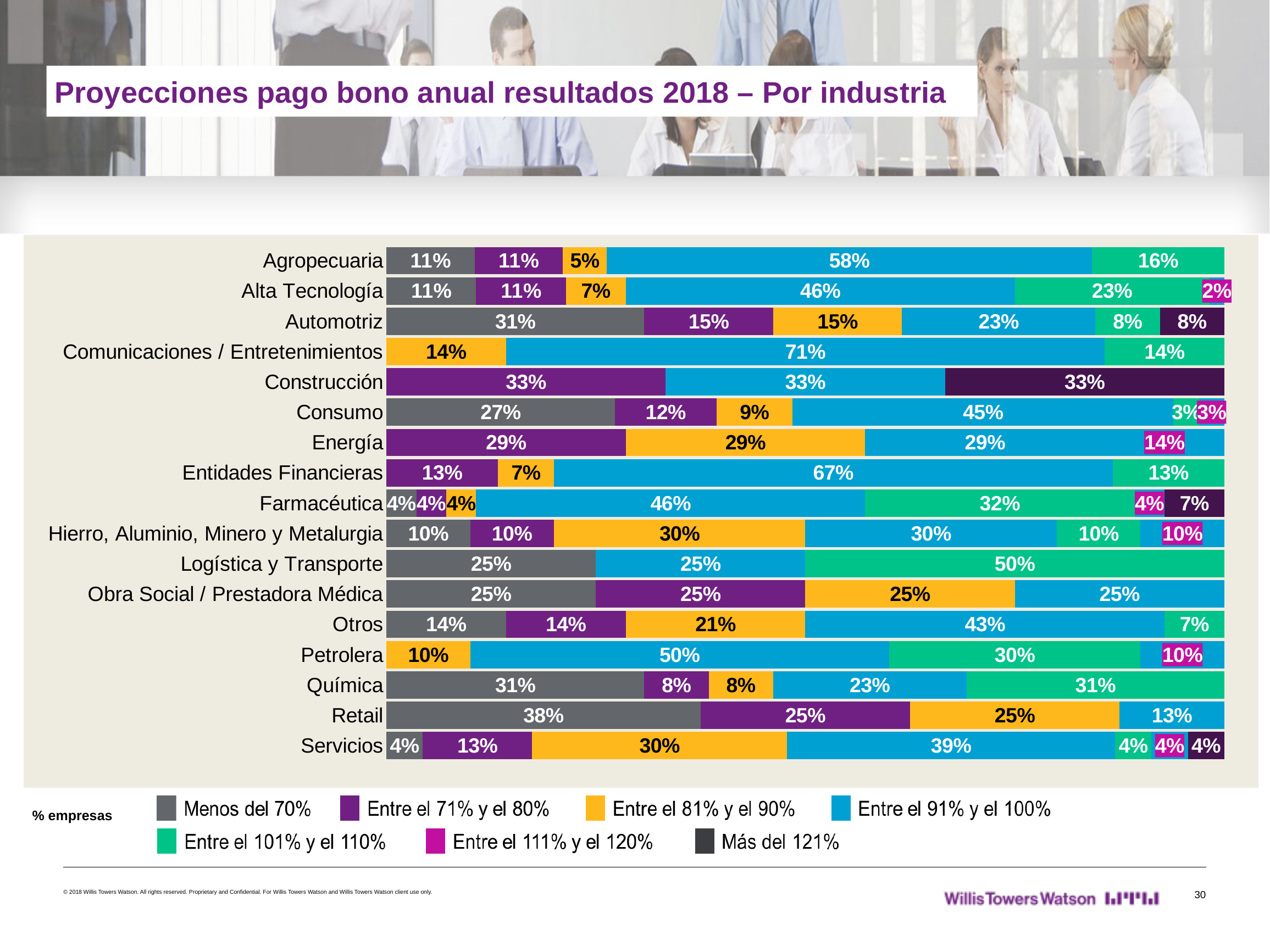
What is the value for Construcción in the 'Más del 121%' series? 33% What is the value for Agropecuaria in the 'Entre el 91% y el 100%' series? 58% What is the value for Comunicaciones / Entretenimientos in the 'Entre el 91% y el 100%' series? 71% How many industries (categories) are listed on the chart? 17 How many series does the legend list? 7 Which has the larger 'Menos del 70%' value, Química or Retail? Retail What kind of chart is shown on the slide? Stacked bar chart Which industry has the highest value in the 'Menos del 70%' series? Retail For Agropecuaria, what is the difference between the 'Entre el 91% y el 100%' value and the 'Entre el 101% y el 110%' value? 42 percentage points What is the value for Logística y Transporte in the 'Entre el 101% y el 110%' series? 50% Which industry has the highest value in the 'Entre el 91% y el 100%' series? Comunicaciones / Entretenimientos What is the value for Retail in the 'Menos del 70%' series? 38%